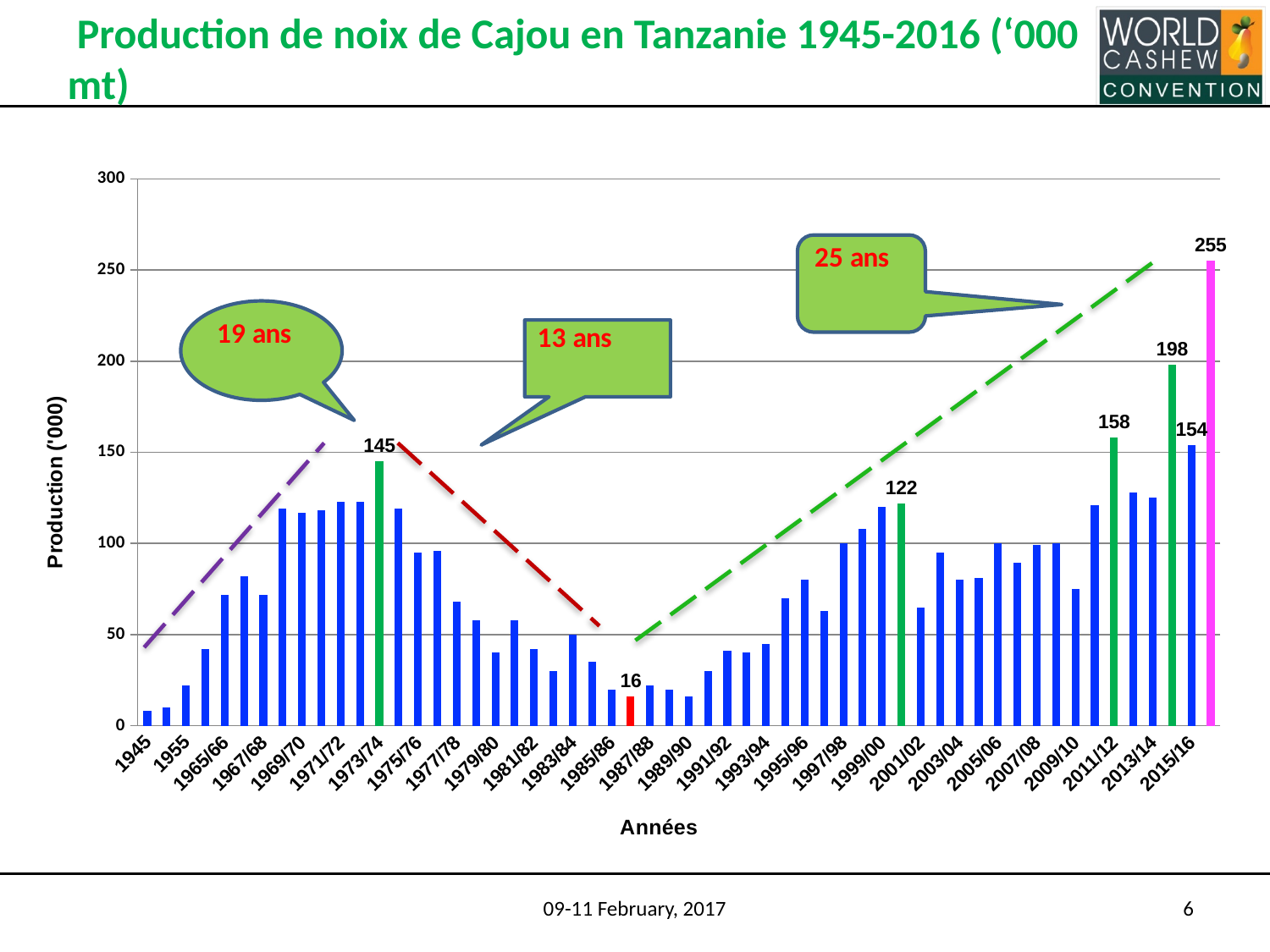
Which year has the lowest bar in the chart? 1945 Which is larger, the value for 2013/14 or the value for 2015/16? 2015/16 Is the value for 1969/70 greater or less than 100? greater What is the value of the tallest bar in the chart? 255 What is the production value for 2015/16? 154 What kind of chart is shown on the slide? bar chart Do the values rise or fall between 1973/74 and 1987/88? fall What is the production value for 1973/74? 145